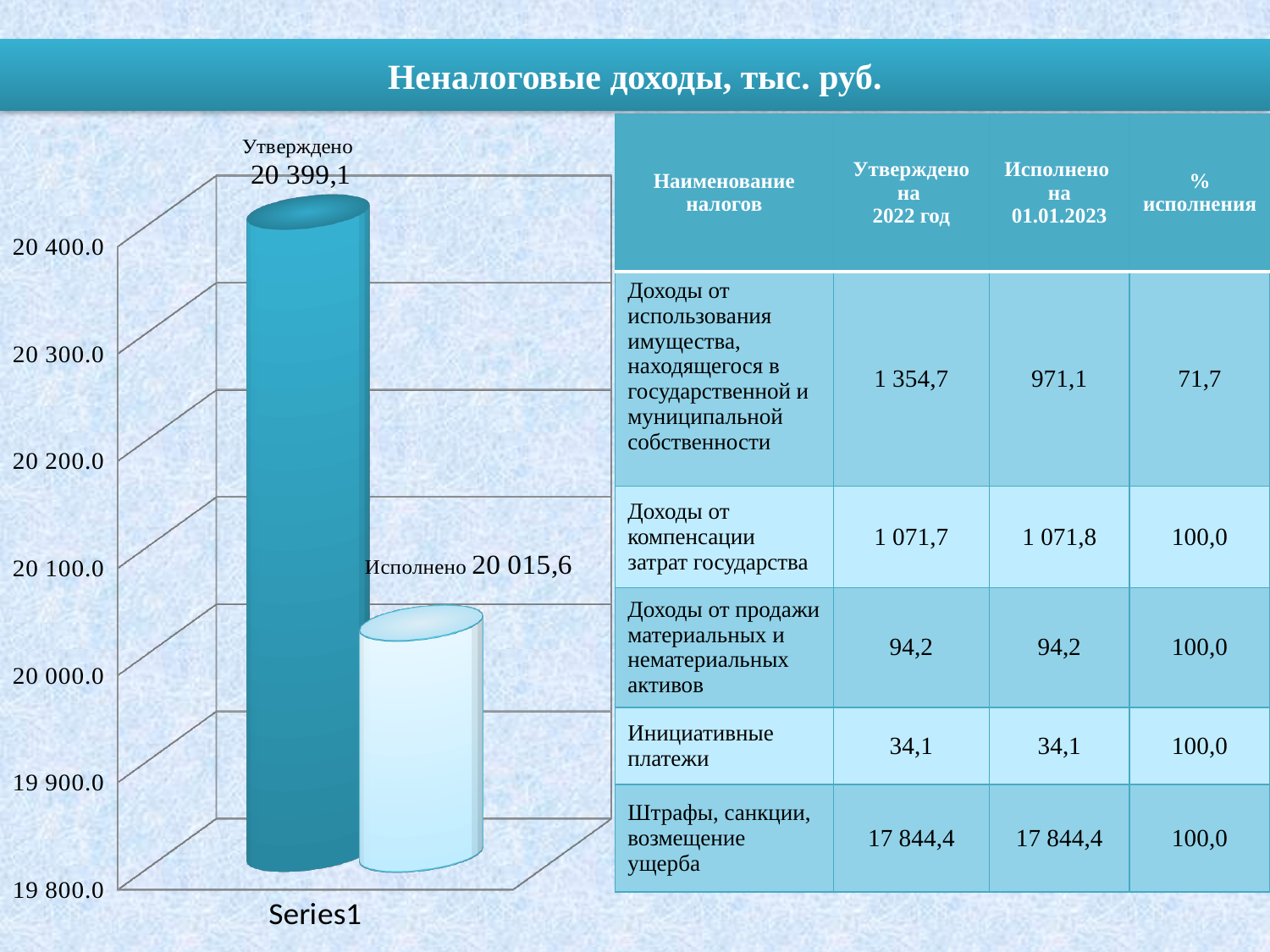
How many bars are plotted in the chart? 2 What is the value of the Исполнено bar in the chart? 20 015,6 Is the value for Исполнено greater or less than 20 100.0? less What kind of chart is shown on the slide? bar chart What label appears under the bars on the category axis of the chart? Series1 Which bar in the chart is higher, Утверждено or Исполнено? Утверждено What is the difference between the Утверждено and Исполнено values in the chart? 383,5 Is the value for Утверждено greater or less than 20 300.0? greater Which bar in the chart is the lowest? Исполнено What is the title of the slide containing the chart? Неналоговые доходы, тыс. руб. What is the value of the Утверждено bar in the chart? 20 399,1 What is the lowest value shown on the vertical axis of the chart? 19 800.0